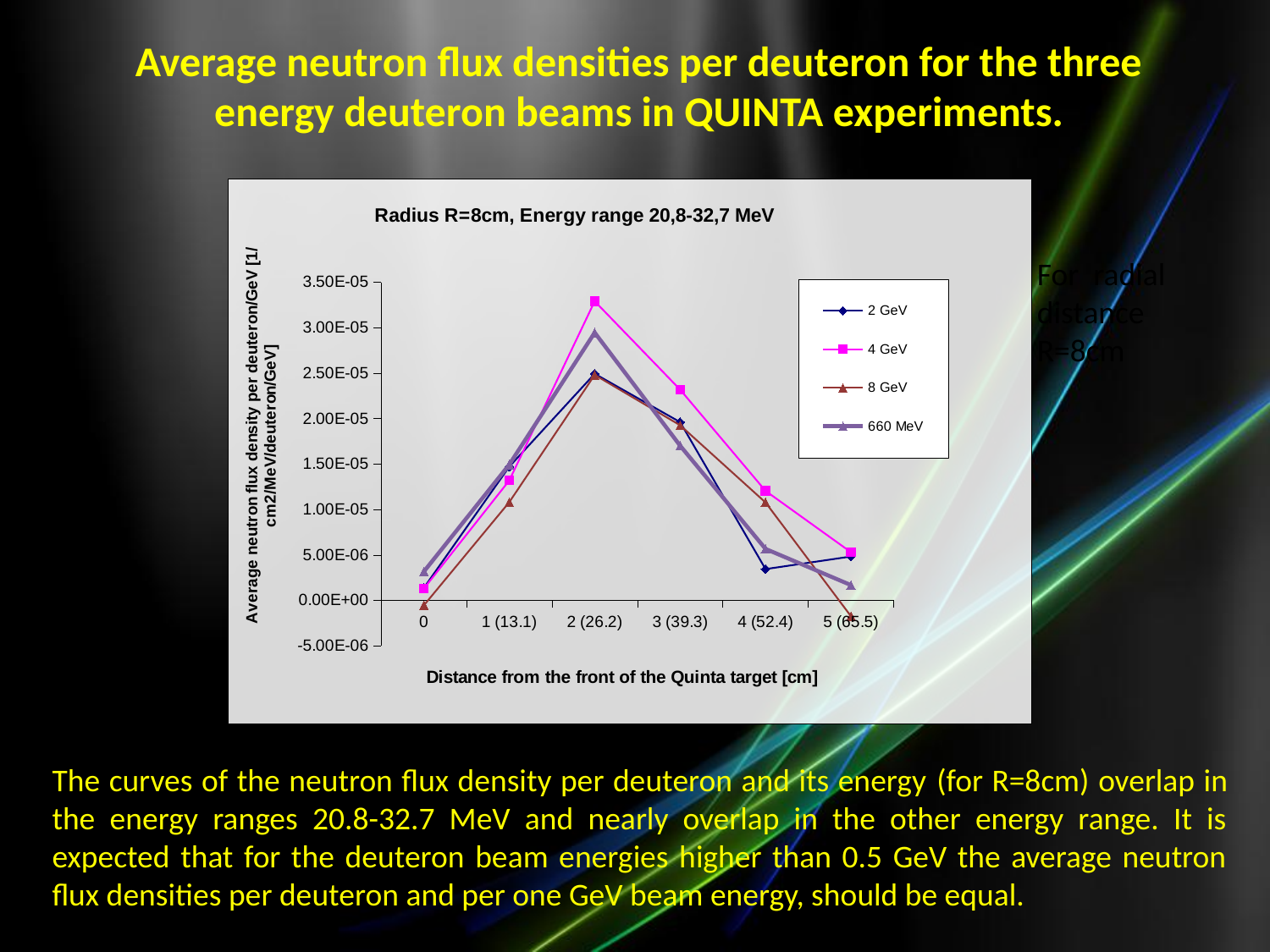
What kind of chart is shown on the slide? line chart Is the value for 660 MeV at 0 greater or less than 5.00E-06? less At which distance does the 4 GeV series reach its highest value? 2 (26.2) Is the value for 4 GeV at 2 (26.2) greater or less than 3.00E-05? greater How many series does the legend list? 4 What is the title of the chart? Radius R=8cm, Energy range 20,8-32,7 MeV Is the value for 8 GeV at 5 (65.5) greater or less than 0.00E+00? less At 2 (26.2), which series has the larger value, 4 GeV or 8 GeV? 4 GeV What is the label of the x axis? Distance from the front of the Quinta target [cm] How many distance points are plotted along the x axis? 6 Does the 4 GeV series rise or fall from 2 (26.2) to 5 (65.5)? fall At which distance does the 8 GeV series reach its lowest value? 5 (65.5)